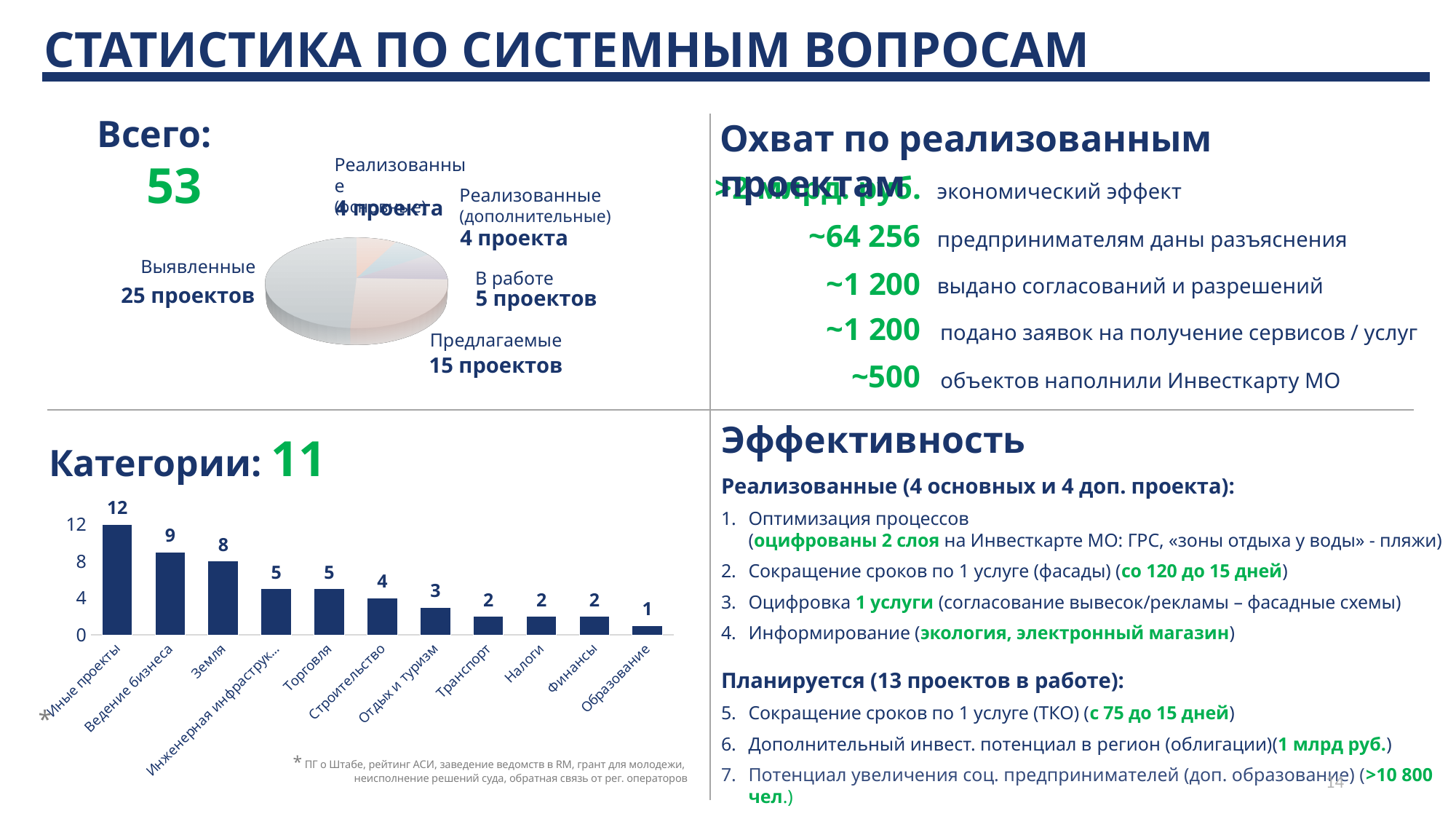
In the bar chart under "Категории: 11", which category has the highest value? Иные проекты In the bar chart under "Категории: 11", how many categories are shown? 11 In the bar chart under "Категории: 11", what is the value for Строительство? 4 In the bar chart under "Категории: 11", which is larger: Торговля or Отдых и туризм? Торговля In the bar chart under "Категории: 11", which category has the lowest value? Образование In the pie chart under "Всего: 53", how many projects are labelled Выявленные? 25 проектов In the pie chart under "Всего: 53", how many projects are labelled Предлагаемые? 15 проектов In the bar chart under "Категории: 11", do the values rise or fall from left to right? Fall In the bar chart under "Категории: 11", what is the difference between the values for Иные проекты and Ведение бизнеса? 3 In the bar chart under "Категории: 11", what is the value for Ведение бизнеса? 9 In the bar chart under "Категории: 11", what is the value for Земля? 8 What kind of chart is shown under "Категории: 11"? Bar chart